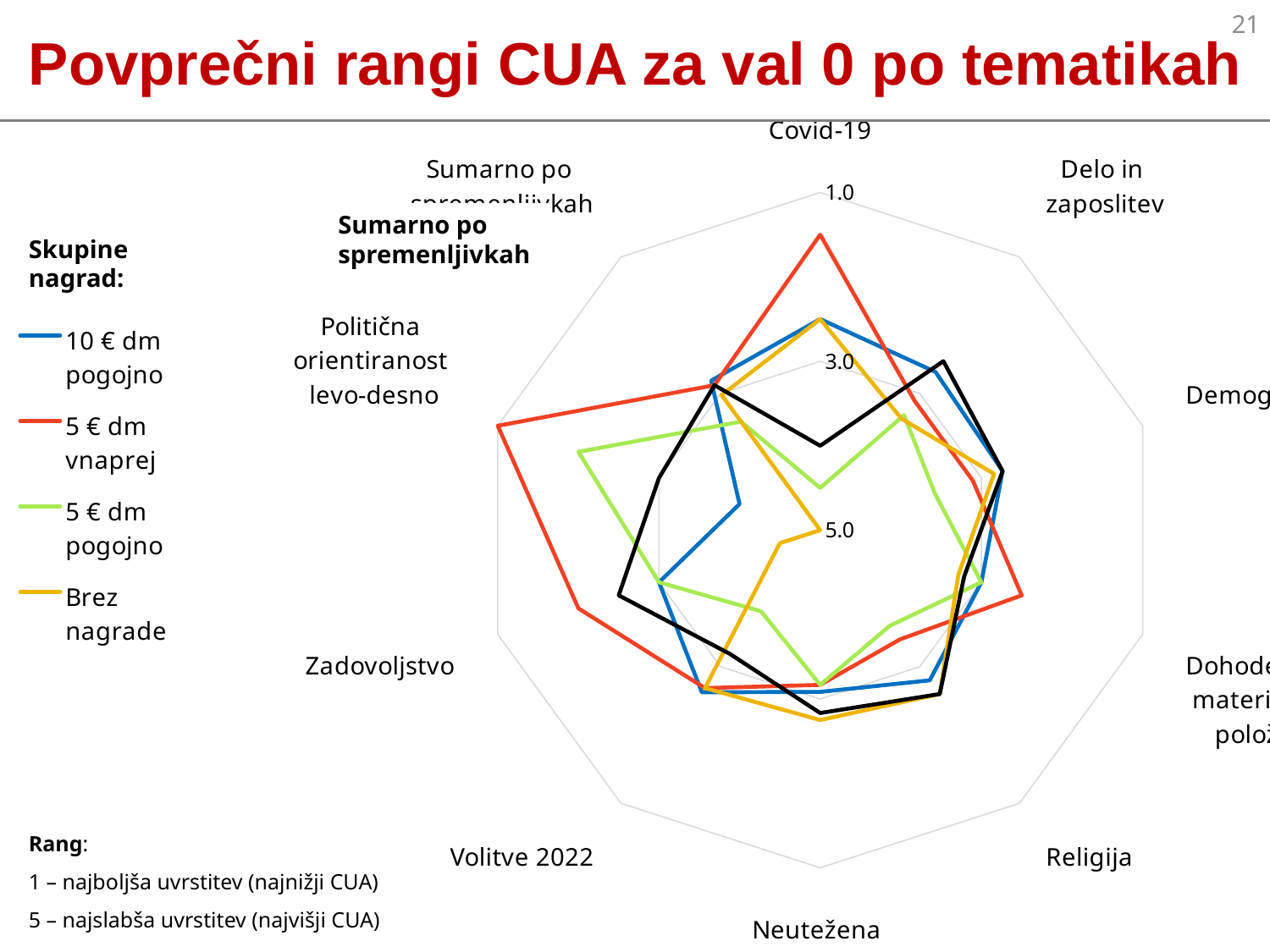
At Covid-19, which has the larger value: '5 € dm vnaprej' or '5 € dm pogojno'? 5 € dm pogojno How many series does the legend (Skupine nagrad) list? 4 Is the value for '5 € dm pogojno' at Covid-19 greater or less than 3.0? greater What is the title of the chart on the slide? Povprečni rangi CUA za val 0 po tematikah Is the value for '5 € dm vnaprej' at Zadovoljstvo greater or less than 3.0? less How many category axes (tematike) does the radar chart have? 10 Which colour represents the series '10 € dm pogojno' in the legend? Blue Is the value for '5 € dm vnaprej' at Covid-19 greater or less than 3.0? less What kind of chart is shown on the slide? Radar chart